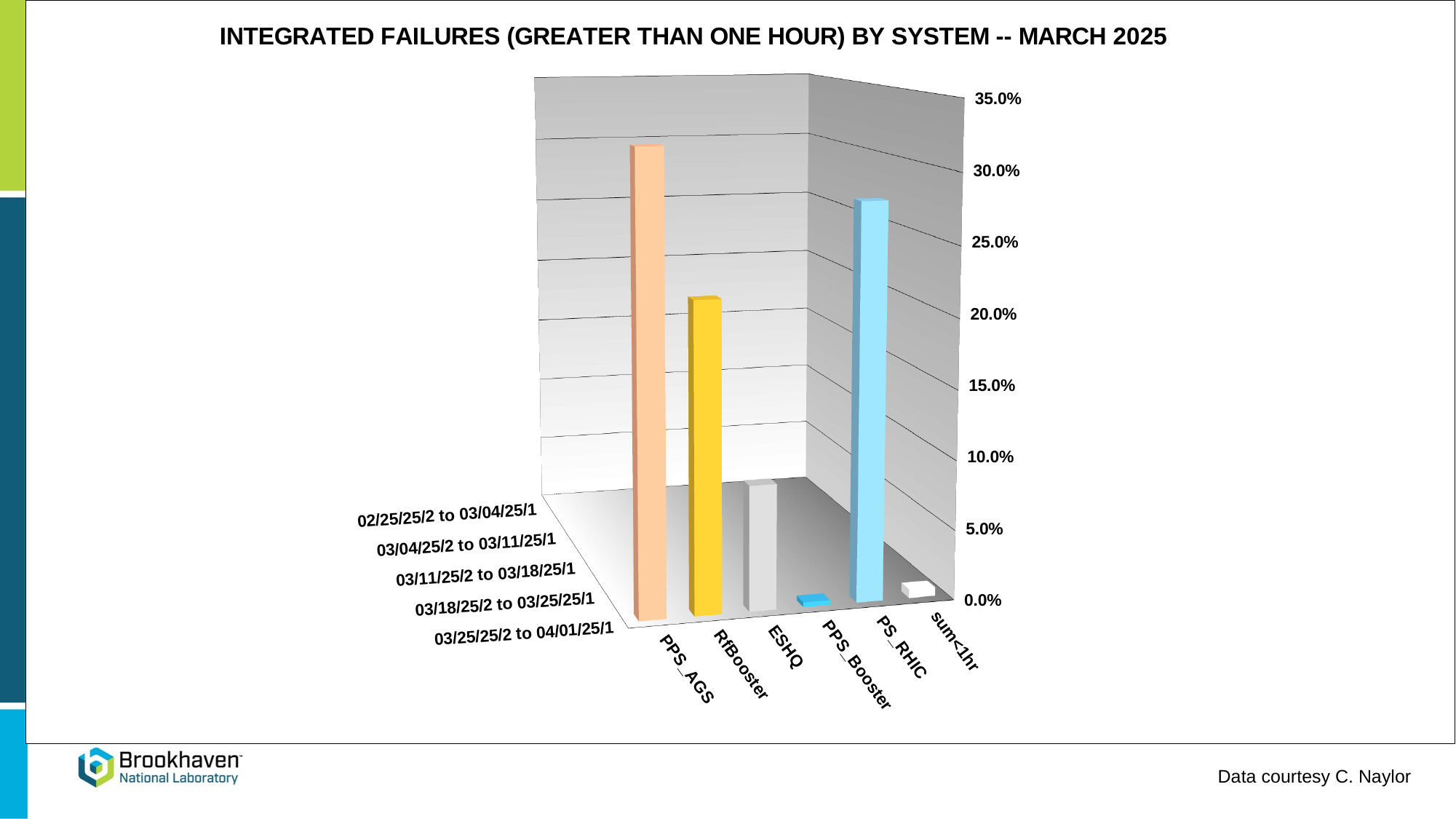
Is the value for ESHQ greater or less than 15.0%? less What type of chart is shown on the slide? bar chart Is the value for RfBooster greater or less than 10.0%? greater Which system has the highest bar? PPS_AGS Which is larger, the value for PS_RHIC or the value for ESHQ? PS_RHIC Is the value for PPS_AGS greater or less than 25.0%? greater How many system categories are shown along the horizontal axis? 6 What is the title of the chart? INTEGRATED FAILURES (GREATER THAN ONE HOUR) BY SYSTEM -- MARCH 2025 How many weekly date ranges are listed on the depth axis of the chart? 5 Which is larger, the value for PPS_AGS or the value for RfBooster? PPS_AGS